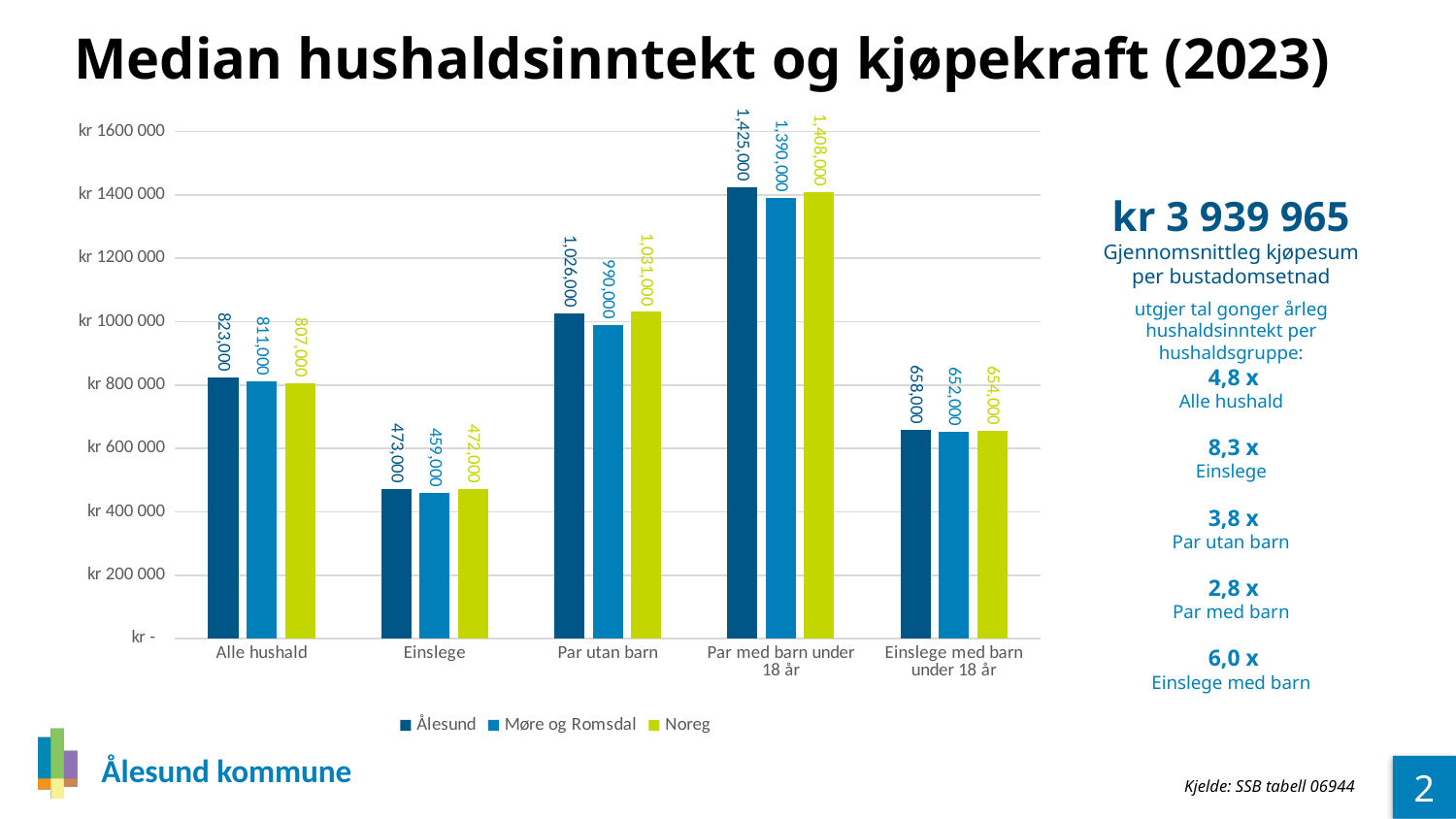
How many series does the legend list? 3 What is the value for Møre og Romsdal in the Par utan barn category? 990,000 What is the value for Noreg in the Einslege med barn under 18 år category? 654,000 Which category has the highest value for Ålesund? Par med barn under 18 år Which category has the lowest value for Noreg? Einslege What kind of chart is shown on the slide? bar chart In the Par utan barn category, which is larger: the value for Ålesund or the value for Møre og Romsdal? Ålesund What is the title of the slide's chart? Median hushaldsinntekt og kjøpekraft (2023) What is the difference between the Ålesund and Møre og Romsdal values in the Par med barn under 18 år category? 35,000 What is the value for Ålesund in the Alle hushald category? 823,000 Is the value for Møre og Romsdal in the Einslege category greater or less than kr 600 000? less How many categories are shown on the x axis? 5